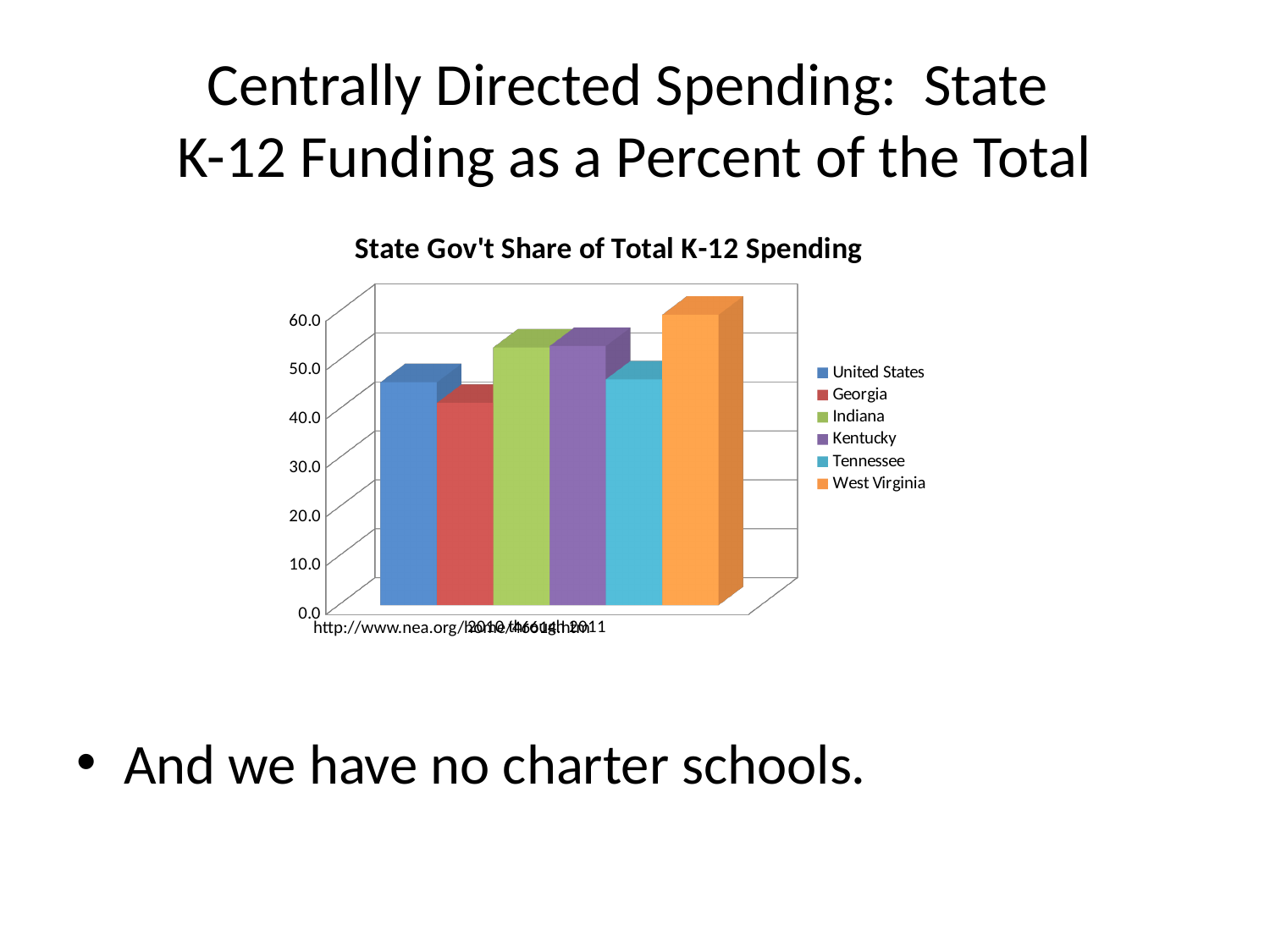
Which is larger, the value for Kentucky or the value for United States? Kentucky What type of chart is shown on the slide? bar chart What is the title of the chart? State Gov't Share of Total K-12 Spending Which colour represents West Virginia in the chart legend? orange Which state or entity has the lowest state government share of total K-12 spending? Georgia How many series does the chart legend list? 6 Which state or entity has the highest state government share of total K-12 spending? West Virginia Is the value for Georgia greater or less than 50.0? less How many bars are plotted in the chart? 6 Which is larger, the value for Indiana or the value for Georgia? Indiana Is the value for United States greater or less than 50.0? less Is the value for West Virginia greater or less than 50.0? greater